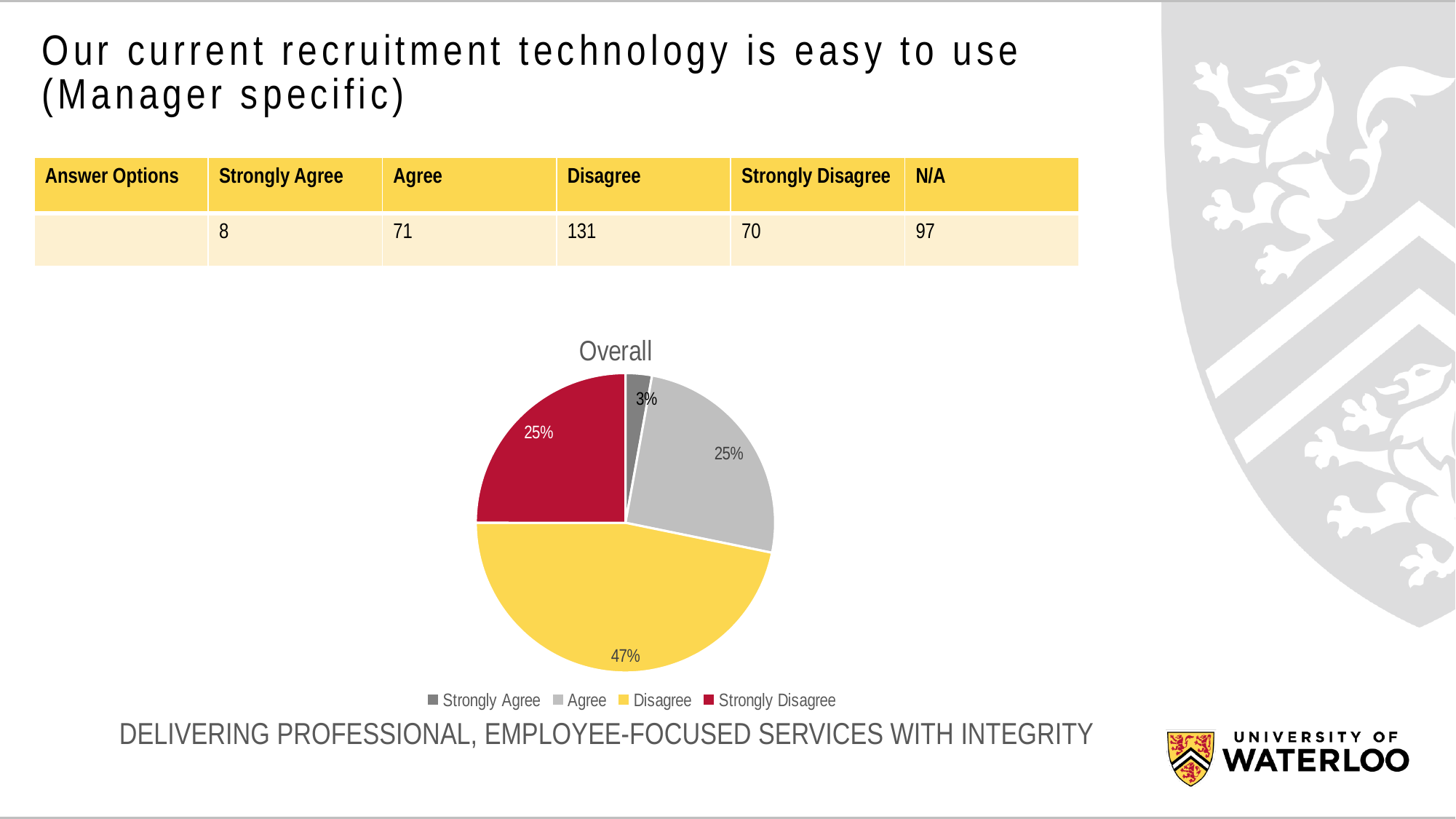
What share of the pie does Agree represent? 25% What share of the pie does Strongly Agree represent? 3% How many slices does the pie chart have? 4 What is the difference in percentage points between the Disagree slice and the Agree slice? 22 What kind of chart is shown on the slide? pie chart How many entries does the legend of the pie chart list? 4 What share of the pie does Disagree represent? 47% Which category has the smallest slice of the pie? Strongly Agree What is the title of the pie chart? Overall Which category has the largest slice of the pie? Disagree Which slice is larger, Disagree or Strongly Disagree? Disagree